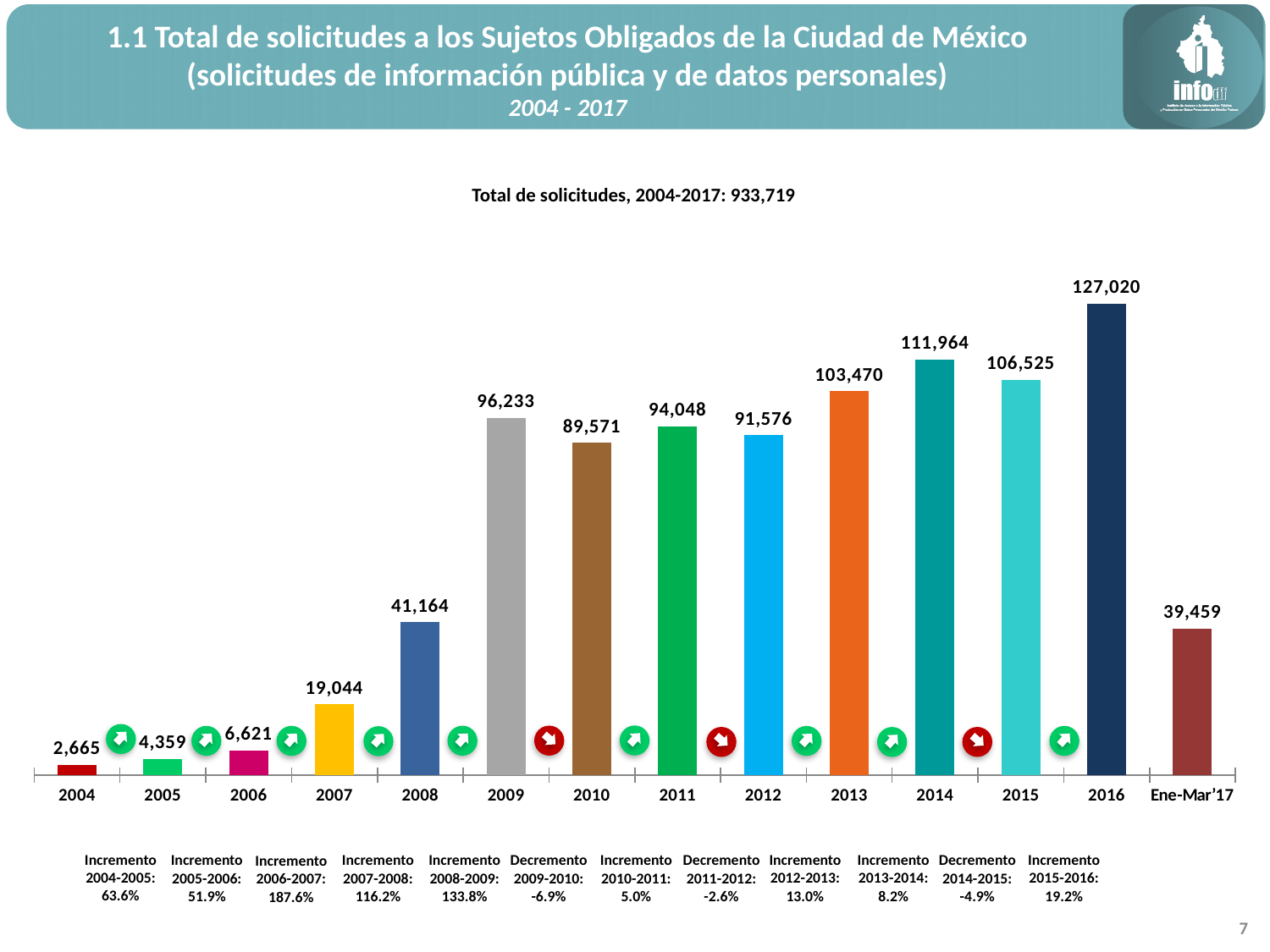
What is the value shown for Ene-Mar'17? 39,459 What is the difference between the values for 2016 and 2015? 20,495 What total of solicitudes for 2004-2017 is stated above the chart? 933,719 How many categories (bars) are plotted on the chart? 14 What is the value shown for 2008? 41,164 What is the difference between the values for 2009 and 2010? 6,662 Which year has the highest number of solicitudes? 2016 Which is larger, the value for 2011 or the value for 2012? 2011 Do the values rise or fall from 2004 to 2009? Rise What is the value shown for 2016? 127,020 What kind of chart is shown on the slide? Bar chart Which category has the lowest value on the chart? 2004